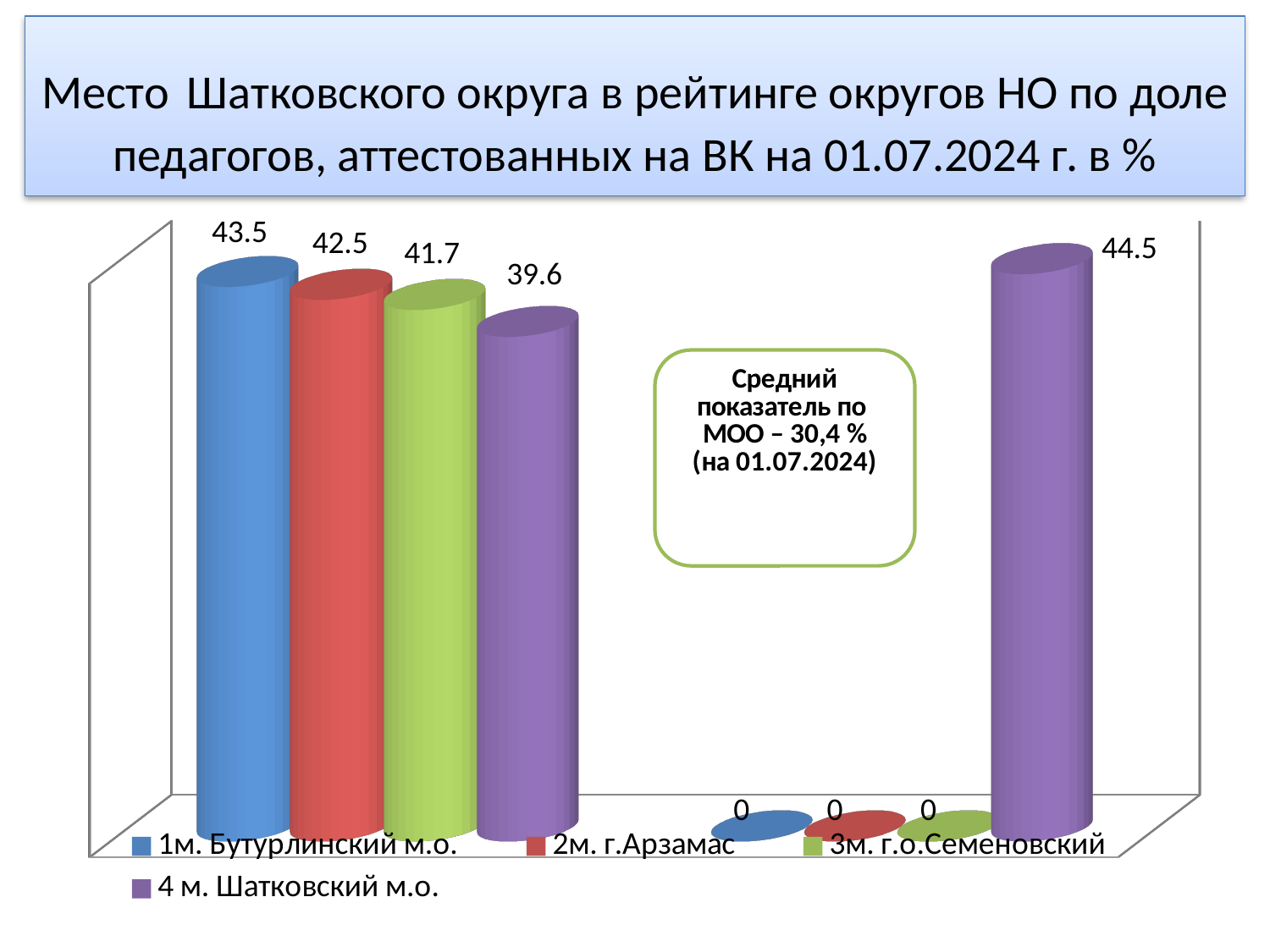
What average indicator for МОО is stated in the text box on the chart? 30,4 % Which series has the highest value in the first group of bars? 1м. Бутурлинский м.о. How many series does the legend list? 4 What value is shown for 2м. г.Арзамас in the first group of bars? 42.5 What value is shown for 4 м. Шатковский м.о. in the first group of bars? 39.6 What value is shown for 3м. г.о.Семеновский in the first group of bars? 41.7 In the first group of bars, which is larger: the value for 2м. г.Арзамас or 3м. г.о.Семеновский? 2м. г.Арзамас What value is shown for 4 м. Шатковский м.о. in the second group of bars? 44.5 What value is shown for 1м. Бутурлинский м.о. in the first group of bars? 43.5 What kind of chart is shown on the slide? Bar chart What is the difference between the values for 1м. Бутурлинский м.о. and 4 м. Шатковский м.о. in the first group of bars? 3.9 Which series has the lowest value in the first group of bars? 4 м. Шатковский м.о.